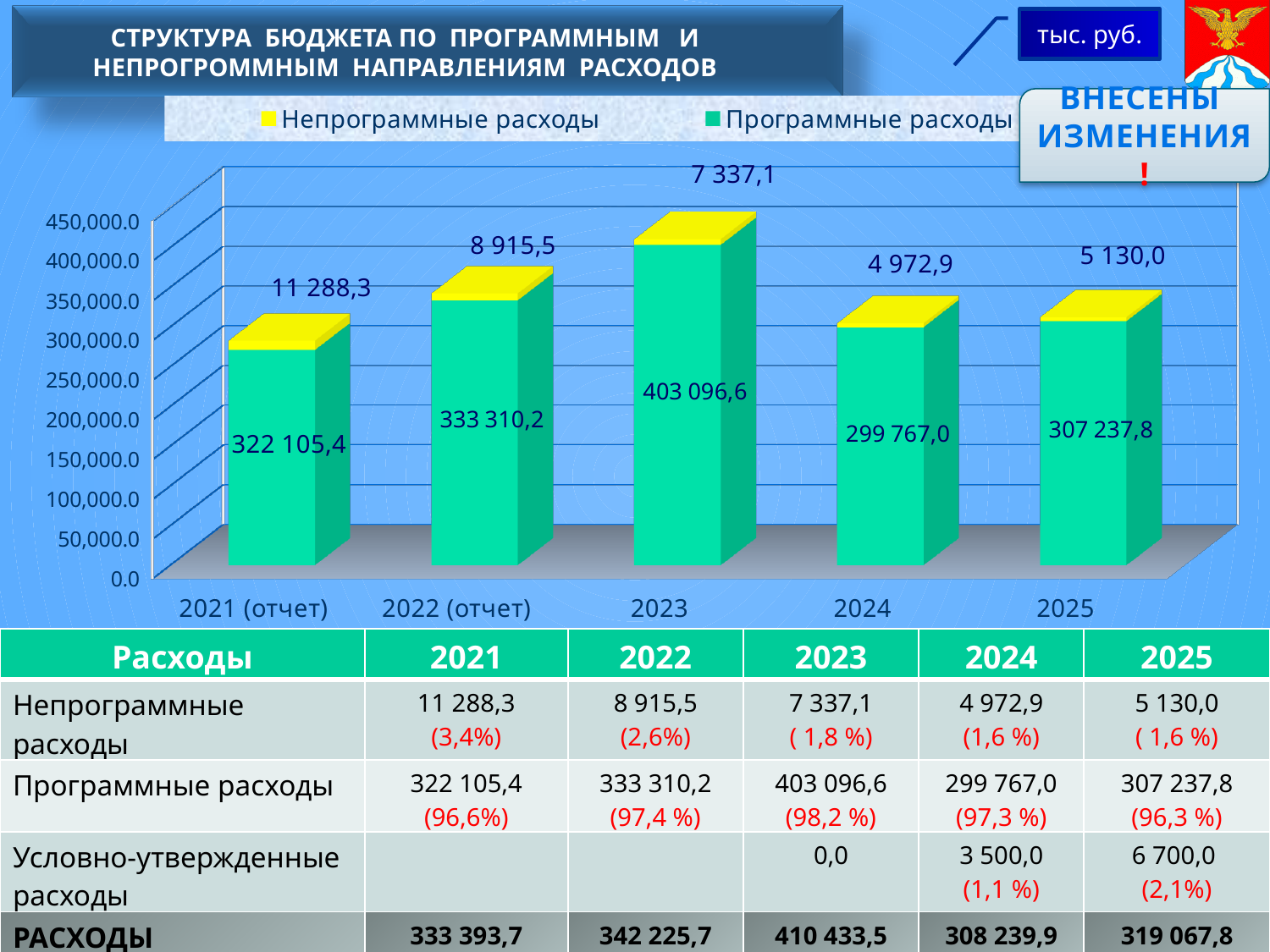
What type of chart is shown on the slide? Stacked bar chart How many year categories are plotted along the x axis of the chart? 5 What is the total of the stacked bar for 2022 (отчет)? 342 225,7 What is the value of Программные расходы for 2023? 403 096,6 How many series does the chart legend list? 2 What is the value of Непрограммные расходы for 2021 (отчет)? 11 288,3 In which year is Непрограммные расходы the lowest? 2024 What is the value of Программные расходы for 2025? 307 237,8 In which year is Программные расходы the highest? 2023 Which colour represents Непрограммные расходы in the chart? Yellow What is the difference between Программные расходы in 2023 and in 2022 (отчет)? 69 786,4 Which is larger: Непрограммные расходы in 2022 (отчет) or in 2025? 2022 (отчет)